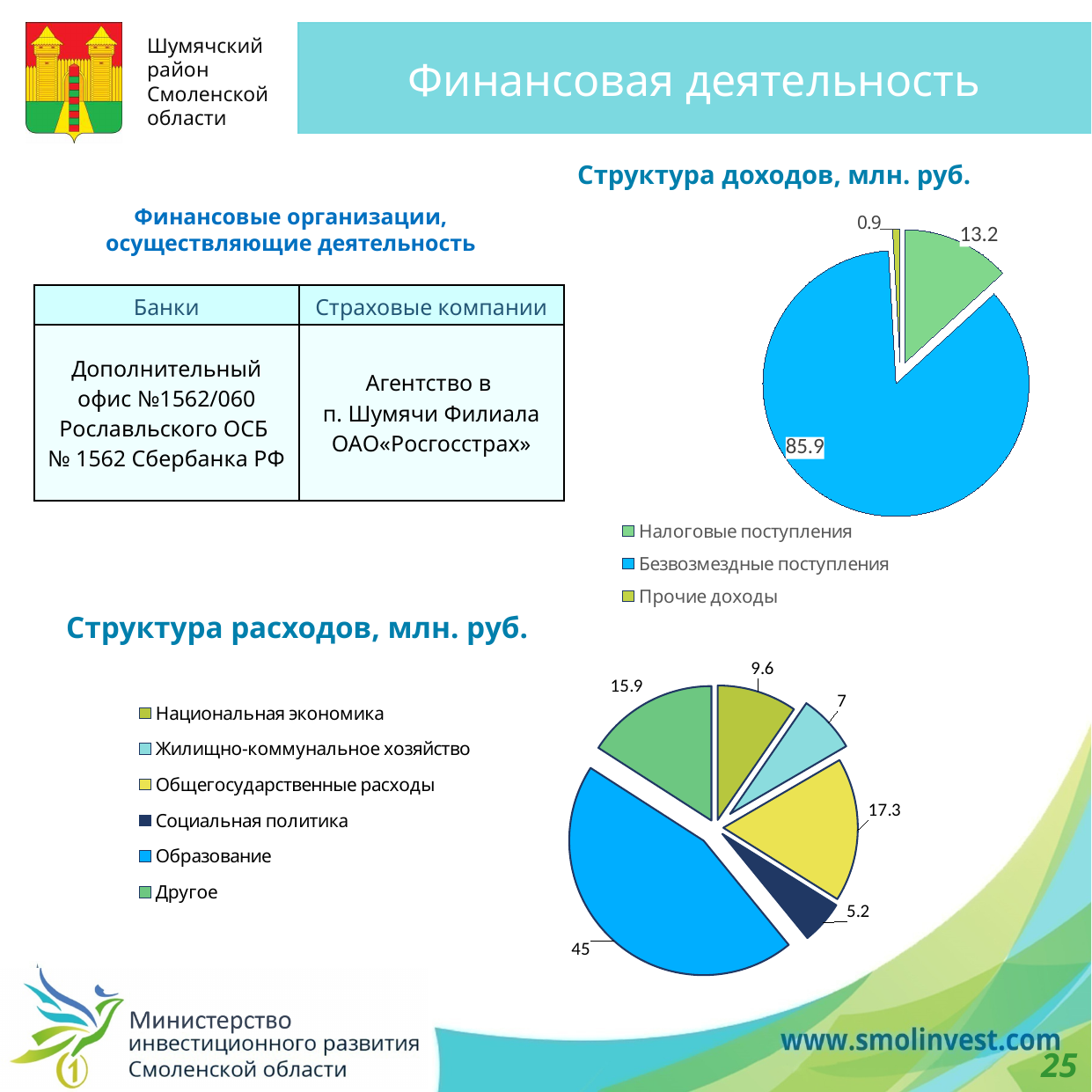
In the 'Структура расходов, млн. руб.' pie chart, which is larger: Национальная экономика or Жилищно-коммунальное хозяйство? Национальная экономика In the 'Структура расходов, млн. руб.' pie chart, which category has the smallest value? Социальная политика In the 'Структура доходов, млн. руб.' pie chart, what is the difference between Безвозмездные поступления and Налоговые поступления? 72.7 In the 'Структура доходов, млн. руб.' pie chart, what is the value for Налоговые поступления? 13.2 In the 'Структура расходов, млн. руб.' pie chart, which category has the largest value? Образование How many categories are shown in the 'Структура расходов, млн. руб.' pie chart? 6 What type of chart is used for 'Структура расходов, млн. руб.'? Pie chart How many categories does the legend of the 'Структура доходов, млн. руб.' chart list? 3 In the 'Структура расходов, млн. руб.' pie chart, what is the value for Общегосударственные расходы? 17.3 In the 'Структура доходов, млн. руб.' pie chart, which category has the smallest value? Прочие доходы In the 'Структура доходов, млн. руб.' pie chart, what is the value for Безвозмездные поступления? 85.9 In the 'Структура расходов, млн. руб.' pie chart, what is the value for Образование? 45